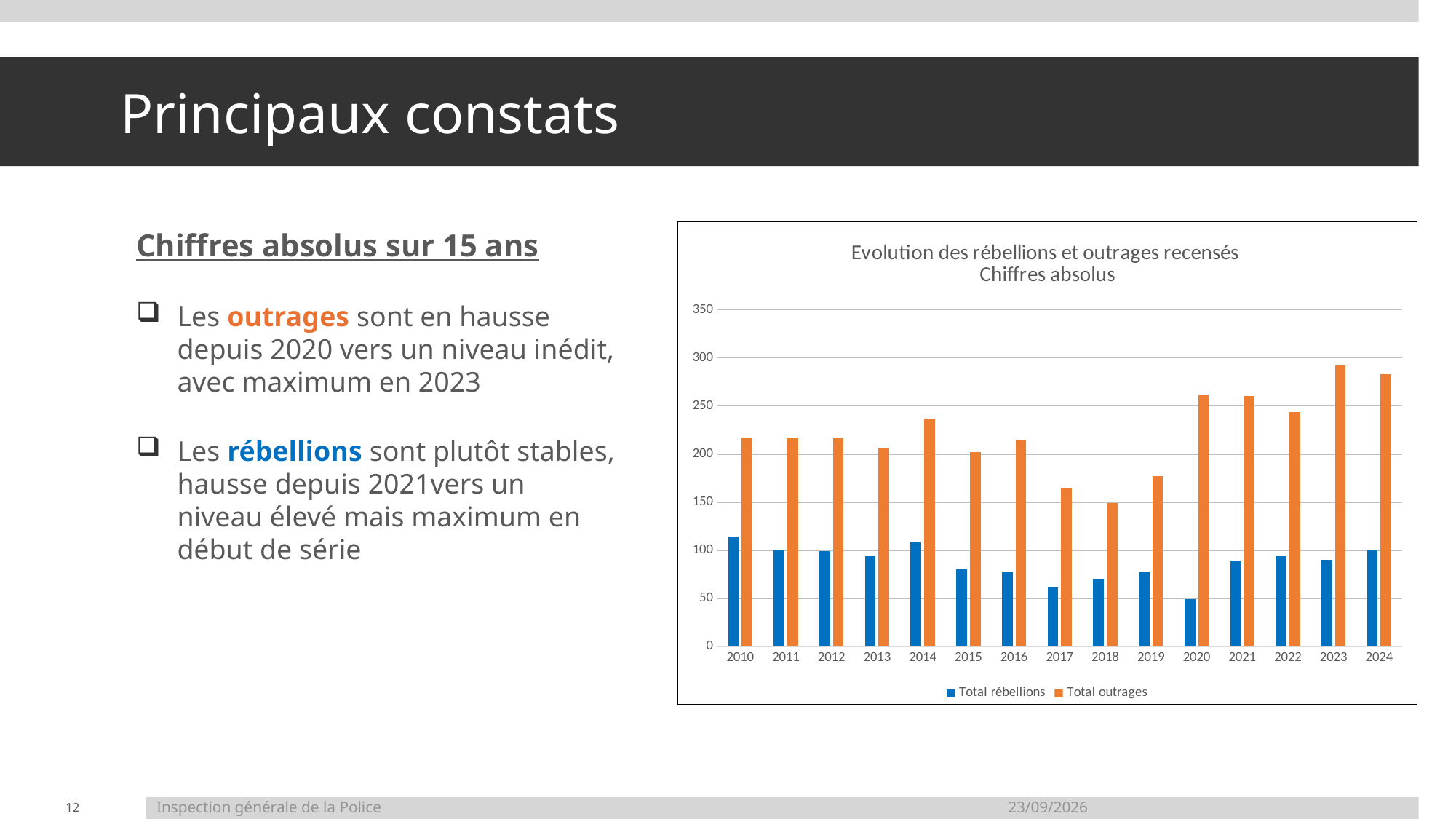
How many series does the legend of the chart list? 2 Do the values for Total rébellions rise or fall from 2010 to 2013? fall In which year is the value for Total outrages lowest? 2018 Is the value for Total rébellions in 2020 greater or less than 100? less How many years are shown on the x axis of the chart? 15 Is the value for Total outrages in 2018 greater or less than 200? less In which year is the value for Total rébellions lowest? 2020 In which year is the value for Total rébellions highest? 2010 Is the value for Total outrages in 2023 greater or less than 250? greater In which year is the value for Total outrages highest? 2023 Which is larger: Total outrages in 2020 or Total outrages in 2019? 2020 What kind of chart is shown on the slide? bar chart